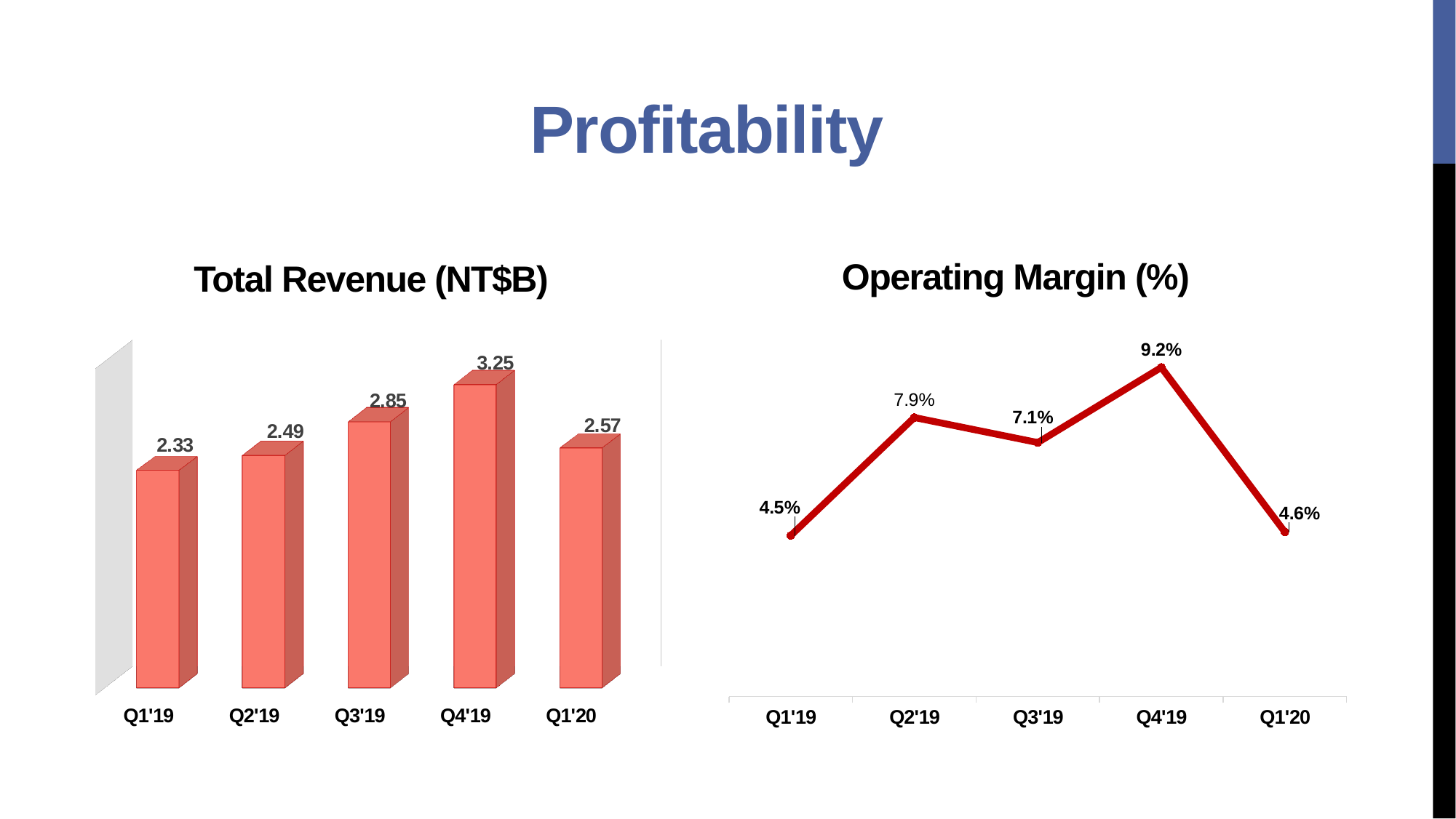
In the Total Revenue (NT$B) chart, what is the difference between Q4'19 and Q1'19? 0.92 In the Total Revenue (NT$B) chart, which is larger, Q3'19 or Q1'20? Q3'19 What kind of chart is the Total Revenue (NT$B) chart? Bar chart In the Total Revenue (NT$B) chart, how many quarters are shown? 5 In the Total Revenue (NT$B) chart, what is the value for Q1'20? 2.57 In the Operating Margin (%) chart, which quarter has the highest operating margin? Q4'19 In the Operating Margin (%) chart, does the value rise or fall from Q4'19 to Q1'20? Fall In the Operating Margin (%) chart, what is the value for Q2'19? 7.9% In the Total Revenue (NT$B) chart, which quarter has the lowest revenue? Q1'19 In the Operating Margin (%) chart, what is the difference between Q4'19 and Q1'20? 4.6% In the Total Revenue (NT$B) chart, what is the value for Q4'19? 3.25 What kind of chart is the Operating Margin (%) chart? Line chart